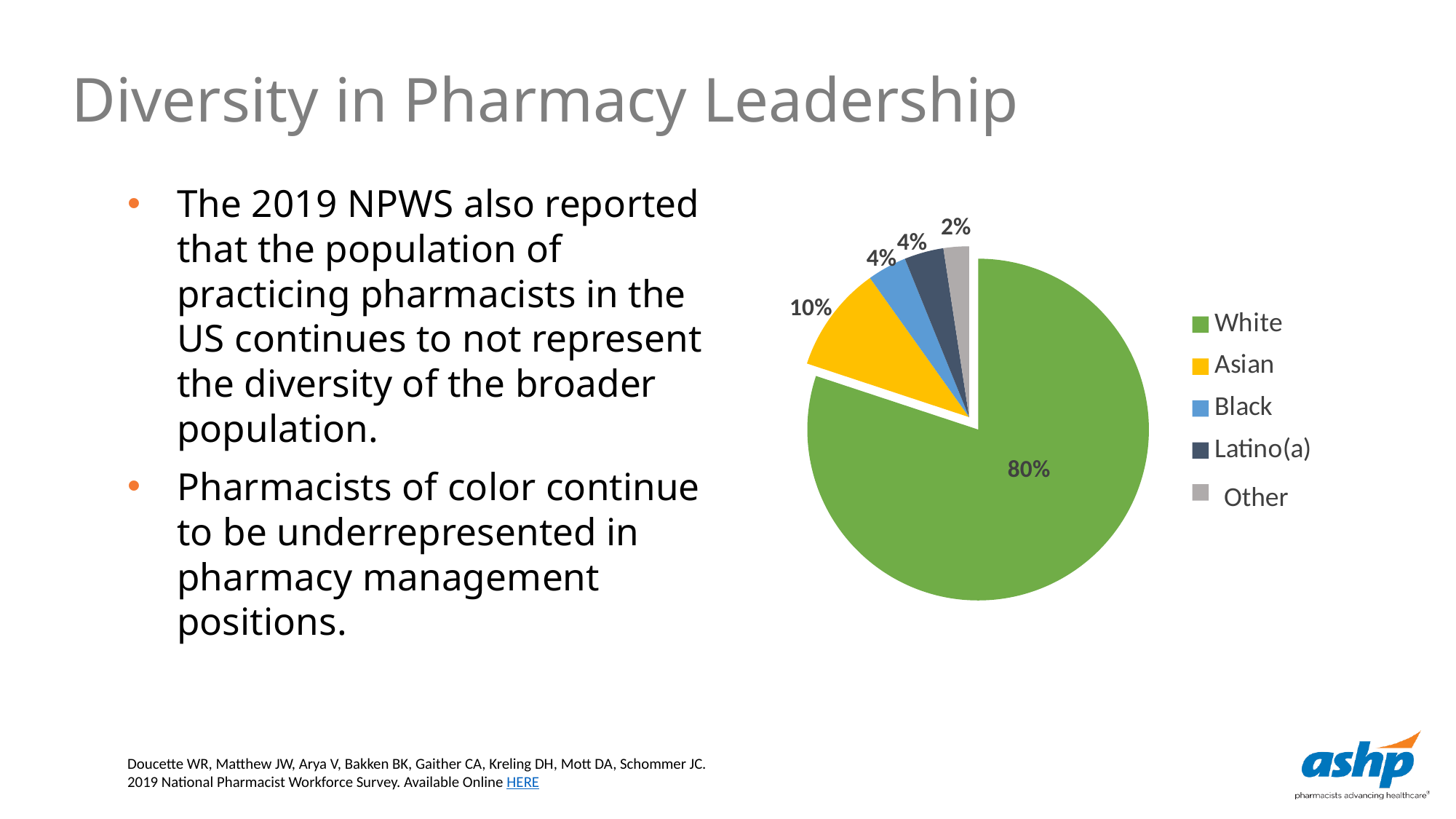
What percentage is shown for Black? 4% What percentage is shown for Asian? 10% What kind of chart is shown on the slide? Pie chart Which is larger, the share for Asian or the share for Latino(a)? Asian How many categories does the pie chart show? 5 Which category has the largest slice of the pie? White What is the difference in percentage points between Asian and Other? 8 What share of the pie does White represent? 80% What colour is the slice for Asian? Yellow What percentage is shown for Other? 2% What is the difference in percentage points between White and Asian? 70 Which category has the smallest slice of the pie? Other